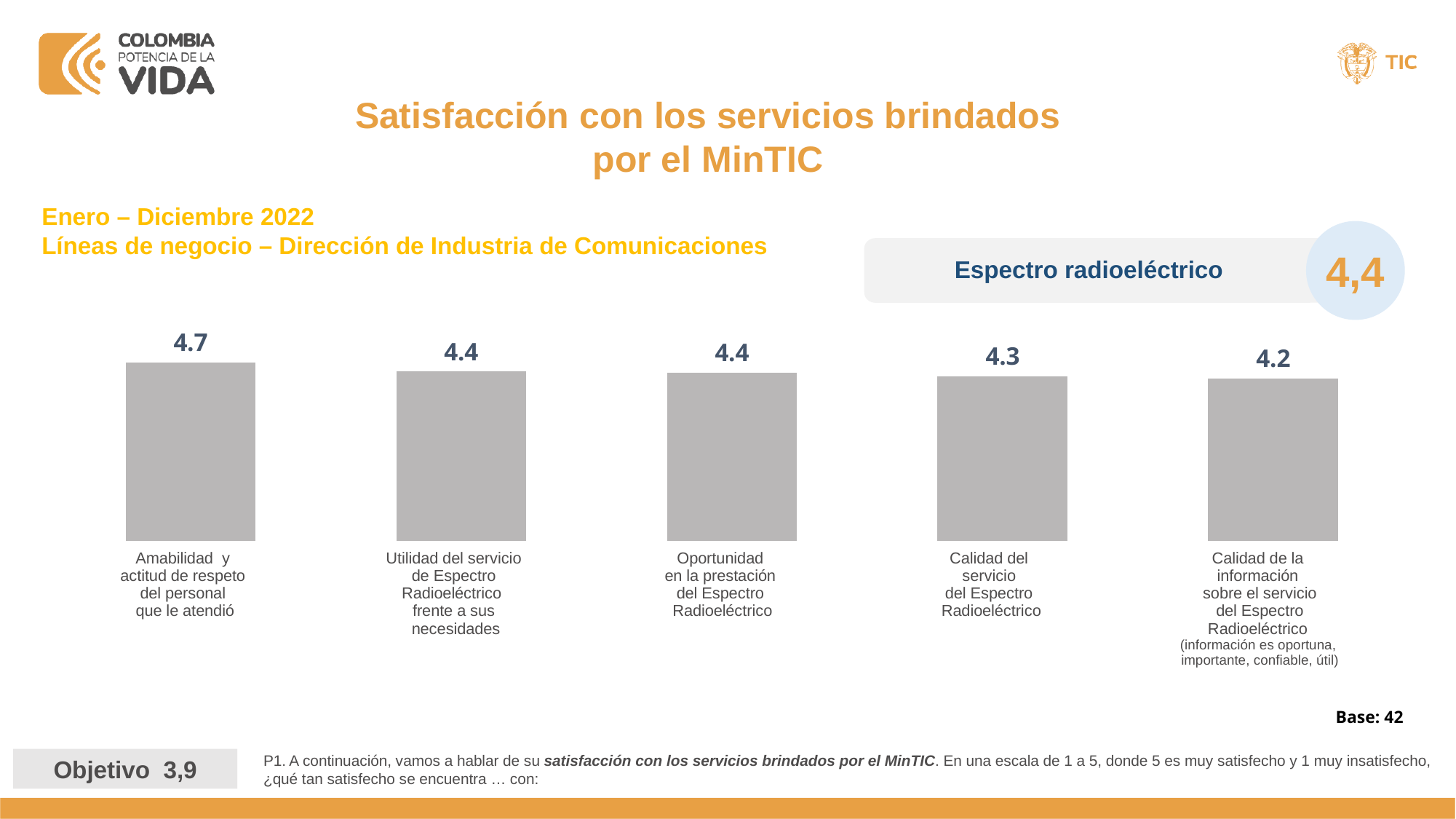
What is the value for 'Oportunidad en la prestación del Espectro Radioeléctrico'? 4.4 What type of chart is used on the slide? Bar chart Which is larger: the value for 'Utilidad del servicio de Espectro Radioeléctrico frente a sus necesidades' or the value for 'Calidad del servicio del Espectro Radioeléctrico'? Utilidad del servicio de Espectro Radioeléctrico frente a sus necesidades Do the values rise or fall from left to right across the categories? Fall What is the satisfaction value for 'Amabilidad y actitud de respeto del personal que le atendió'? 4.7 Which category has the lowest satisfaction value? Calidad de la información sobre el servicio del Espectro Radioeléctrico What overall score is shown for 'Espectro radioeléctrico' in the circle at the top right? 4,4 What is the value for 'Calidad de la información sobre el servicio del Espectro Radioeléctrico'? 4.2 How many categories are shown in the bar chart? 5 What is the difference between the highest value (4.7) and the lowest value (4.2)? 0.5 Which category has the highest satisfaction value? Amabilidad y actitud de respeto del personal que le atendió What is the value shown for 'Calidad del servicio del Espectro Radioeléctrico'? 4.3